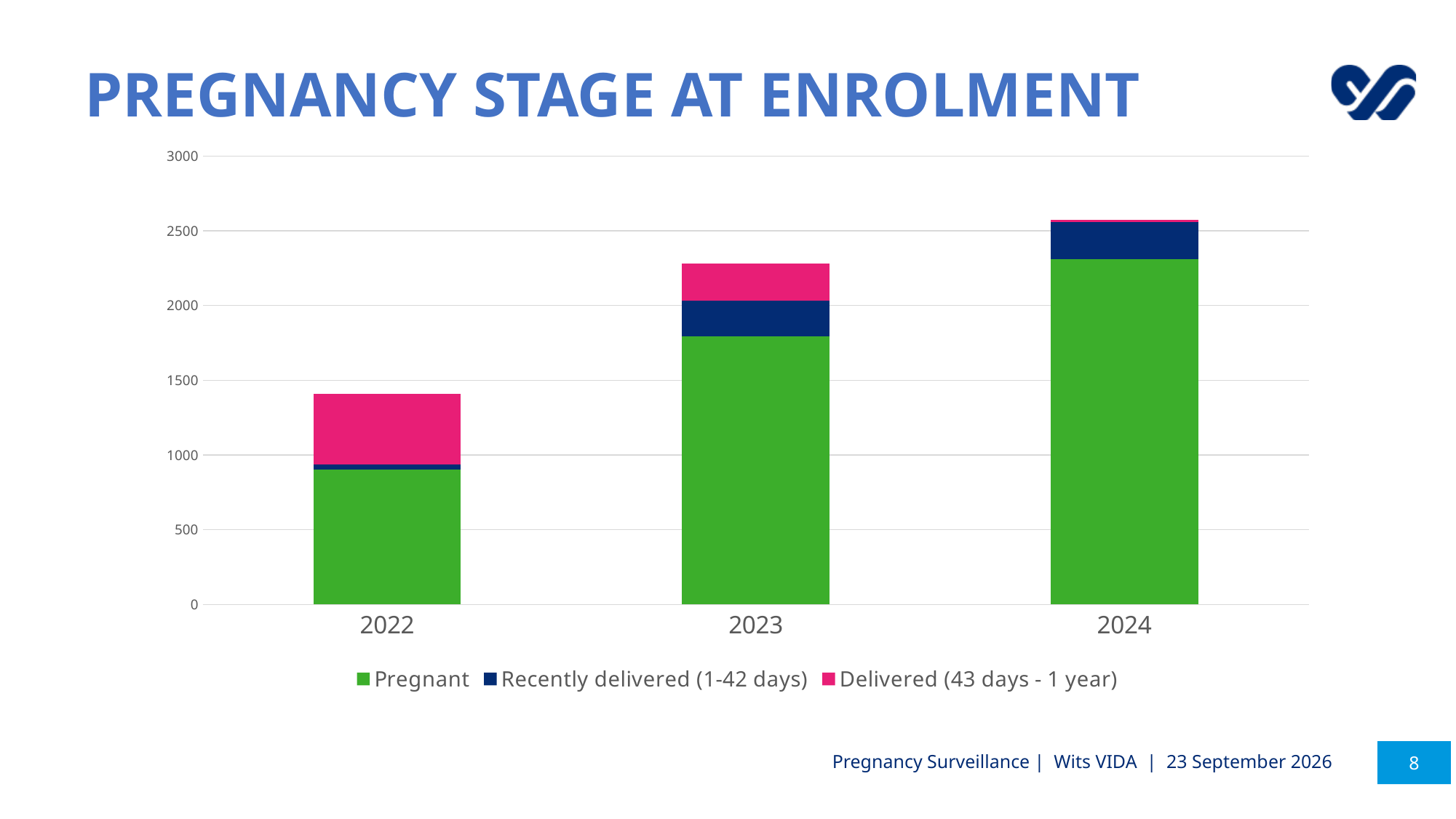
Is the total bar for 2024 greater or less than 2500? greater What kind of chart is shown on the slide? stacked bar chart How many series does the legend list? 3 Which year has the highest total bar? 2024 What is the title of the chart? PREGNANCY STAGE AT ENROLMENT Which series is shown in green? Pregnant Do the total bar heights rise or fall from 2022 to 2024? rise How many years are shown on the x axis? 3 Is the total bar for 2022 greater or less than 1500? less Is the Pregnant segment for 2023 greater or less than 1500? greater Which year has the lowest total bar? 2022 Which year has the larger Delivered (43 days - 1 year) segment, 2022 or 2024? 2022